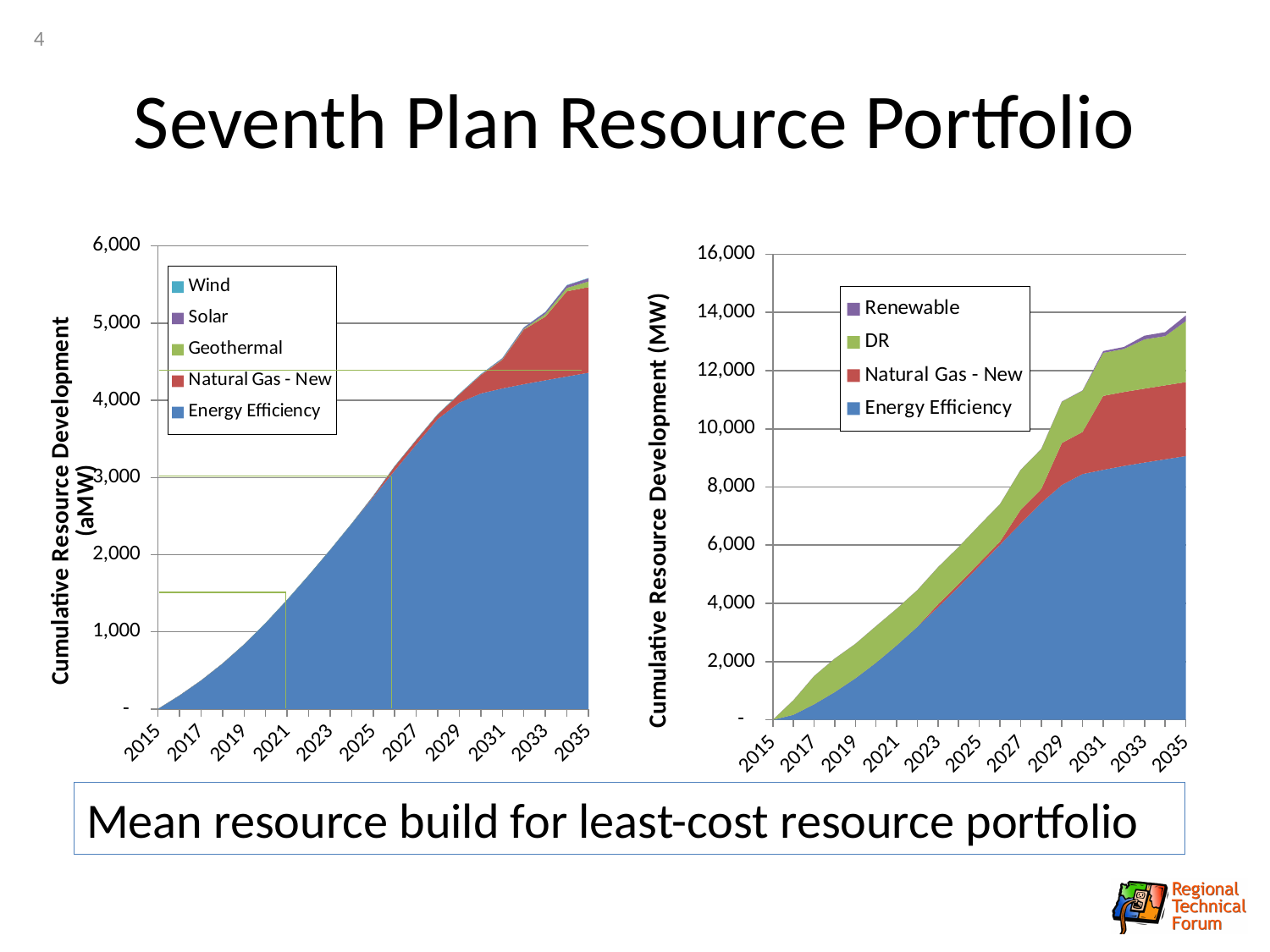
Which series is listed first in the legend of the right chart (MW)? Renewable In the right chart (MW), does the total cumulative resource development rise or fall over the years shown? Rise In the right chart (MW), is the Energy Efficiency value in 2035 greater or less than 8,000? greater What is the y-axis label of the left chart? Cumulative Resource Development (aMW) In the left chart (aMW), is the Energy Efficiency value in 2035 greater or less than 4,000? greater In the right chart (MW), is the total cumulative resource development in 2035 greater or less than 12,000? greater What kind of chart is the left chart (Cumulative Resource Development (aMW))? Stacked area chart How many series does the legend of the right chart (MW) list? 4 How many series does the legend of the left chart (aMW) list? 5 In the right chart (MW), which series contributes more in 2035, Energy Efficiency or Natural Gas - New? Energy Efficiency In the left chart (aMW), does the cumulative resource development rise or fall from 2015 to 2035? Rise